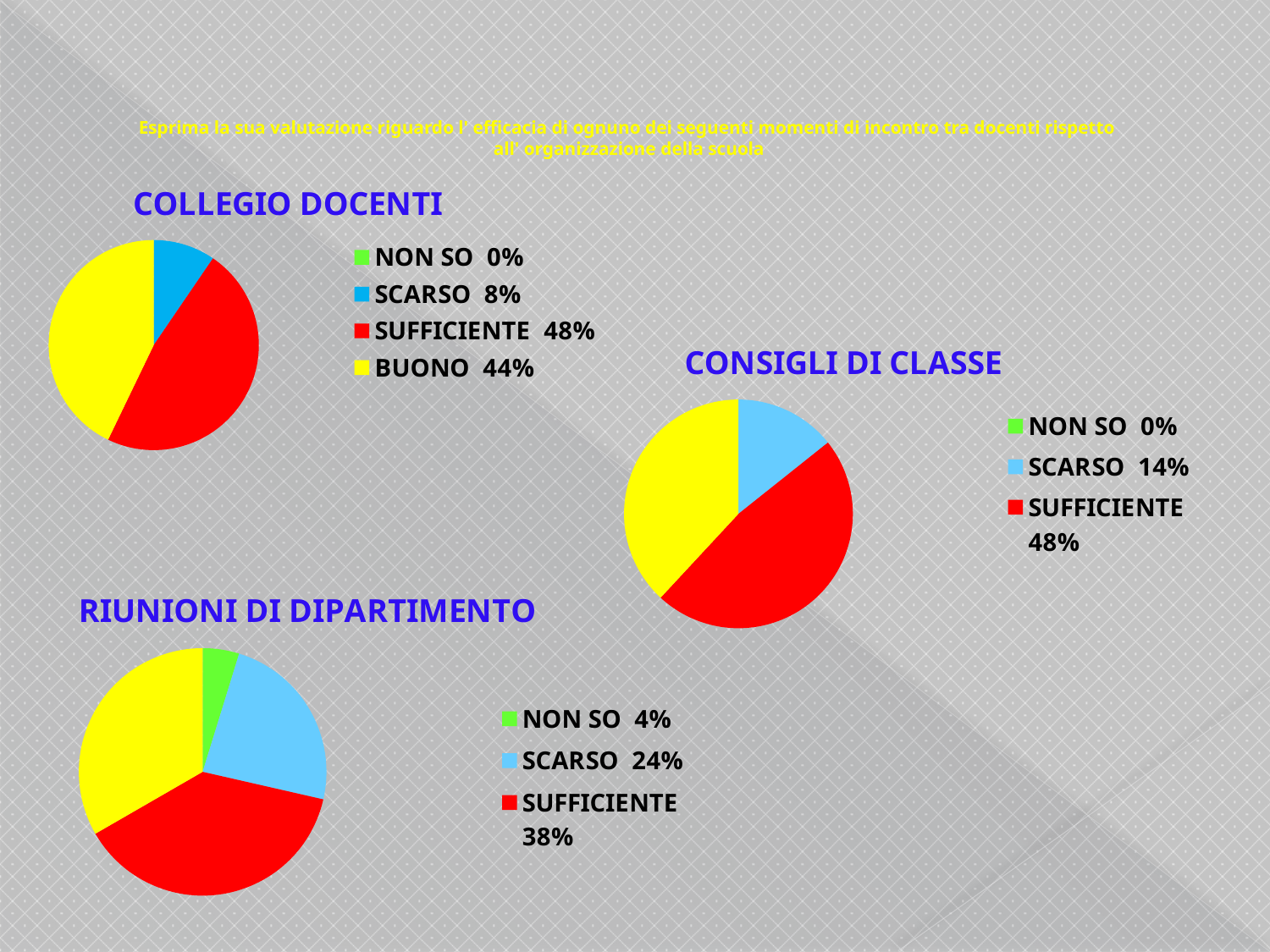
In the CONSIGLI DI CLASSE chart, what is the difference between SUFFICIENTE and SCARSO? 34 percentage points How many entries does the legend of the COLLEGIO DOCENTI chart list? 4 In the COLLEGIO DOCENTI chart, which category has the highest value? SUFFICIENTE In the COLLEGIO DOCENTI chart, what is the value for SCARSO? 8% What kind of chart is used for COLLEGIO DOCENTI? Pie chart In the RIUNIONI DI DIPARTIMENTO chart, which is larger, SCARSO or SUFFICIENTE? SUFFICIENTE In the RIUNIONI DI DIPARTIMENTO chart, what colour is the SUFFICIENTE slice? Red In the COLLEGIO DOCENTI chart, what is the difference between SUFFICIENTE and BUONO? 4 percentage points In the COLLEGIO DOCENTI chart, which category has the lowest value? NON SO In the CONSIGLI DI CLASSE chart, what is the value for SCARSO? 14% In the COLLEGIO DOCENTI chart, what share of the pie is BUONO? 44% In the RIUNIONI DI DIPARTIMENTO chart, what is the value for NON SO? 4%